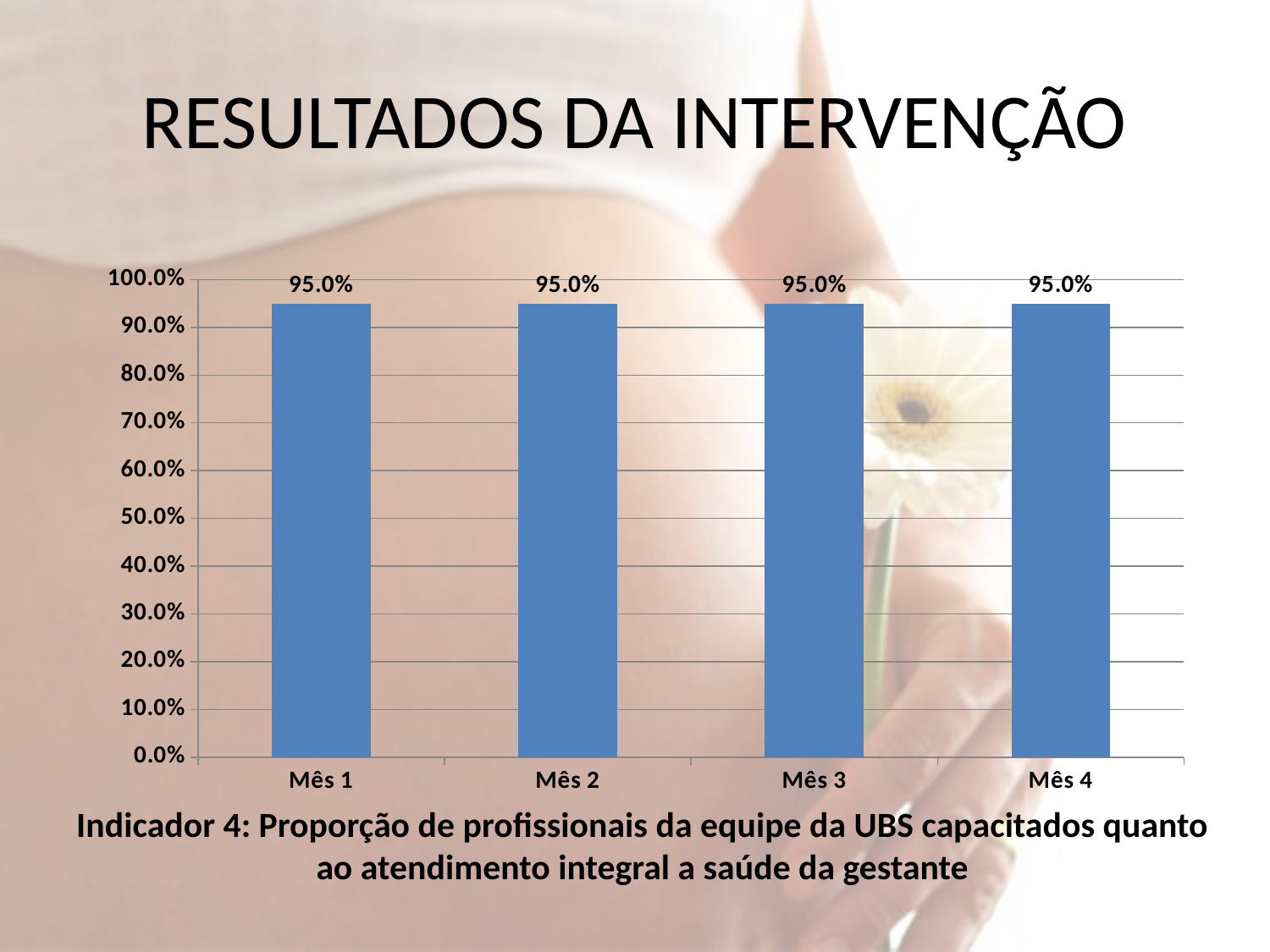
What is the label of the first category on the x axis? Mês 1 What kind of chart is shown on the slide? Bar chart Is the value for Mês 3 greater or less than 100.0%? less Is the value for Mês 2 greater or less than 90.0%? greater Do the values rise, fall or stay the same from Mês 1 to Mês 4? Stay the same What is the highest value shown on the y axis? 100.0% What is the value for Mês 4? 95.0% What is the value for Mês 1? 95.0% What is the value for Mês 3? 95.0% What is the difference between the values for Mês 2 and Mês 4? 0.0% How many categories are shown on the x axis? 4